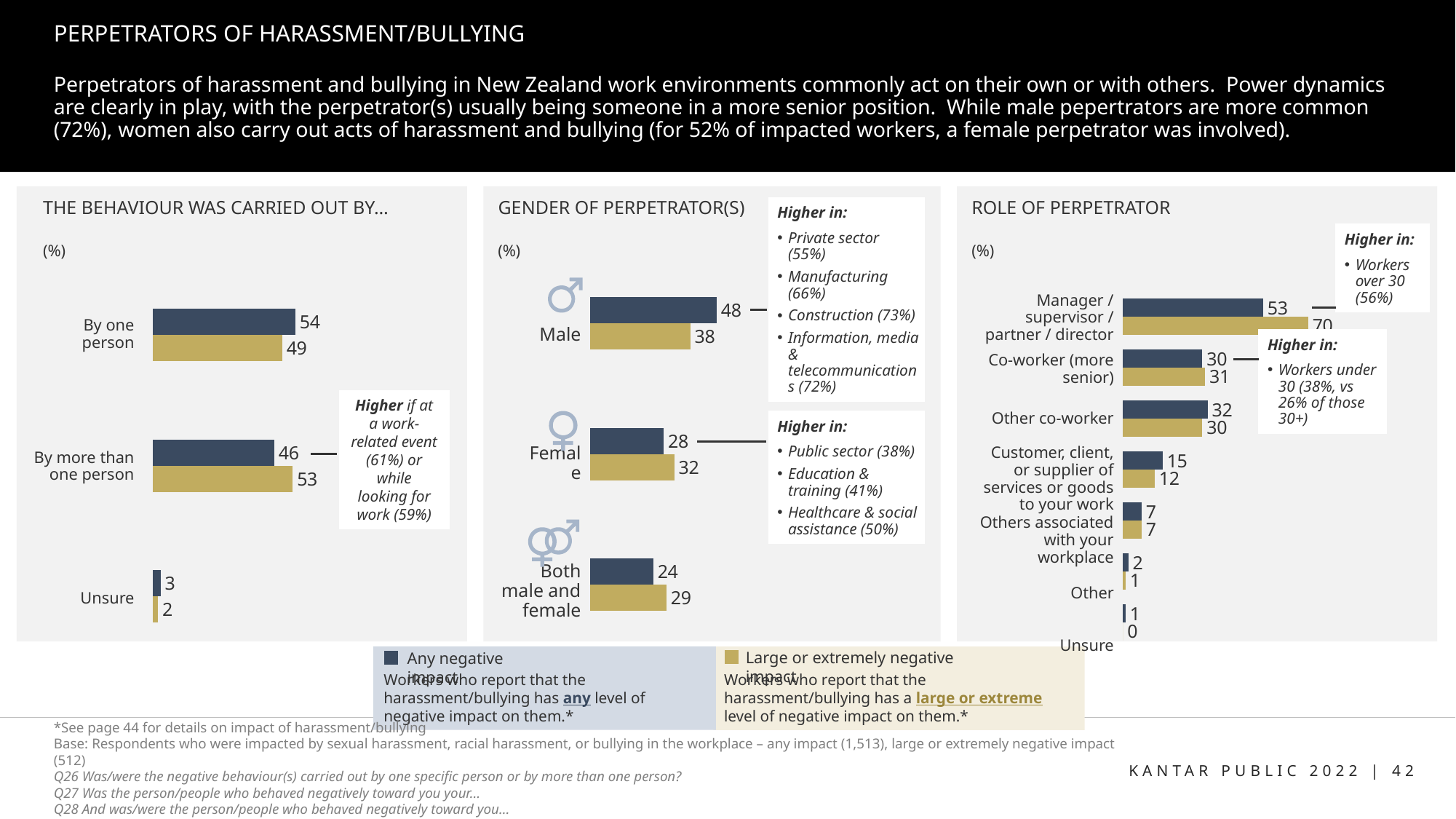
In the 'THE BEHAVIOUR WAS CARRIED OUT BY...' chart, what is the 'Any negative impact' value for 'By one person'? 54 How many role categories are shown in the 'ROLE OF PERPETRATOR' chart? 7 In the 'THE BEHAVIOUR WAS CARRIED OUT BY...' chart, what is the difference between the two series' values for 'By more than one person'? 7 In the 'THE BEHAVIOUR WAS CARRIED OUT BY...' chart, what is the 'Large or extremely negative impact' value for 'By more than one person'? 53 In the 'ROLE OF PERPETRATOR' chart, what is the difference between the 'Any negative impact' and 'Large or extremely negative impact' values for 'Manager / supervisor / partner / director'? 17 In the 'GENDER OF PERPETRATOR(S)' chart, what is the 'Any negative impact' value for Male? 48 How many series does the legend list for the charts on this slide? 2 In the 'ROLE OF PERPETRATOR' chart, which role has the highest 'Any negative impact' value? Manager / supervisor / partner / director What type of chart is the 'GENDER OF PERPETRATOR(S)' chart? Bar chart In the 'GENDER OF PERPETRATOR(S)' chart, which category has the lowest 'Any negative impact' value? Both male and female In the 'ROLE OF PERPETRATOR' chart, what is the 'Large or extremely negative impact' value for 'Manager / supervisor / partner / director'? 70 In the 'GENDER OF PERPETRATOR(S)' chart, which is larger for Female: the 'Any negative impact' value or the 'Large or extremely negative impact' value? Large or extremely negative impact